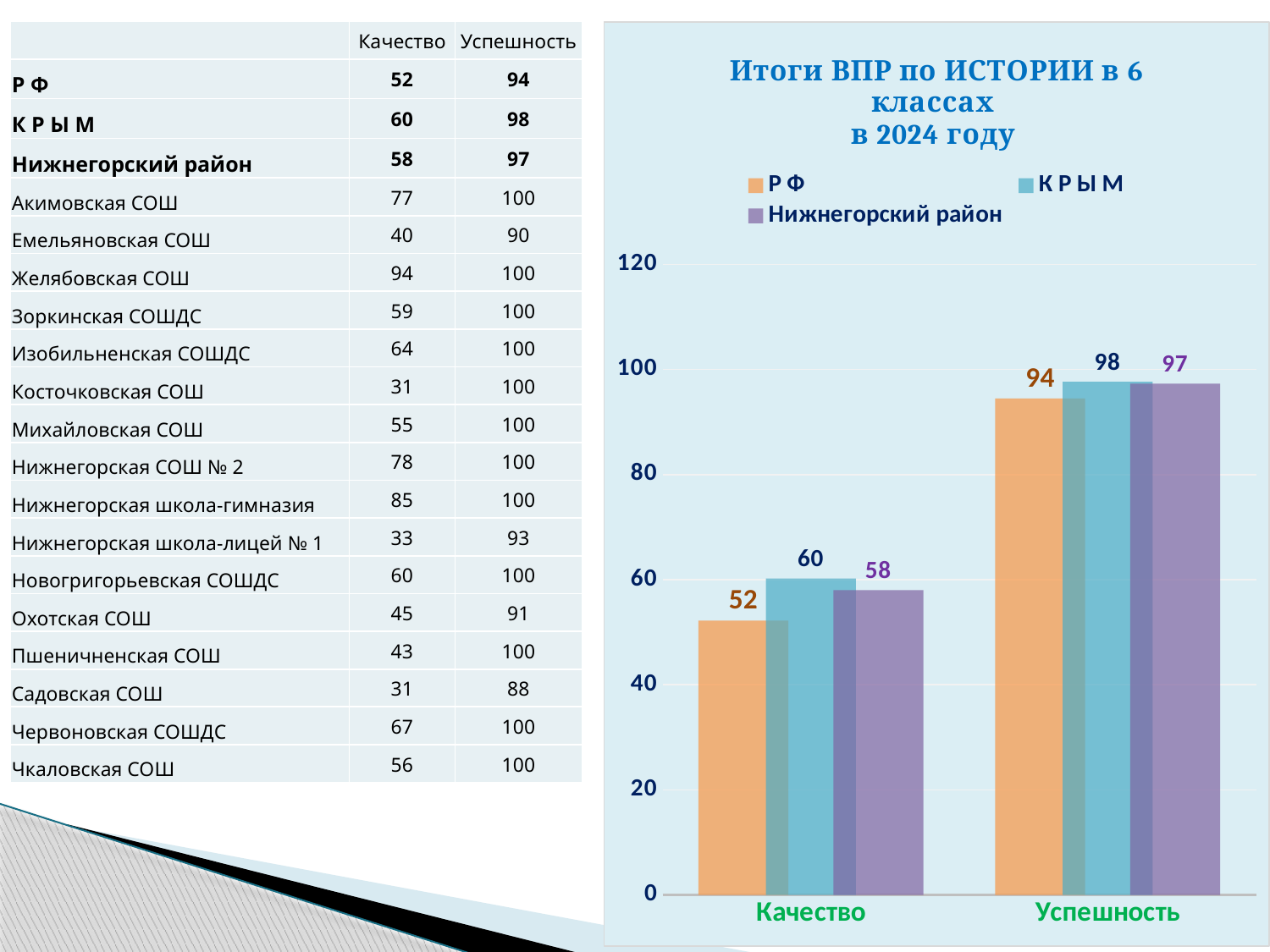
What is the value for Р Ф in the Качество category? 52 What is the value for Нижнегорский район in the Успешность category? 97 What is the title of the chart? Итоги ВПР по ИСТОРИИ в 6 классах в 2024 году What is the value for Нижнегорский район in the Качество category? 58 Which is larger: the Р Ф value for Успешность or the Нижнегорский район value for Успешность? Нижнегорский район Which series has the lowest value in the Успешность category? Р Ф Which series has the highest value in the Качество category? К Р Ы М What is the value for К Р Ы М in the Успешность category? 98 How many series does the legend list? 3 What kind of chart is shown on the slide? Bar chart What is the difference between the К Р Ы М and Р Ф values in the Качество category? 8 How many categories are shown on the x axis? 2